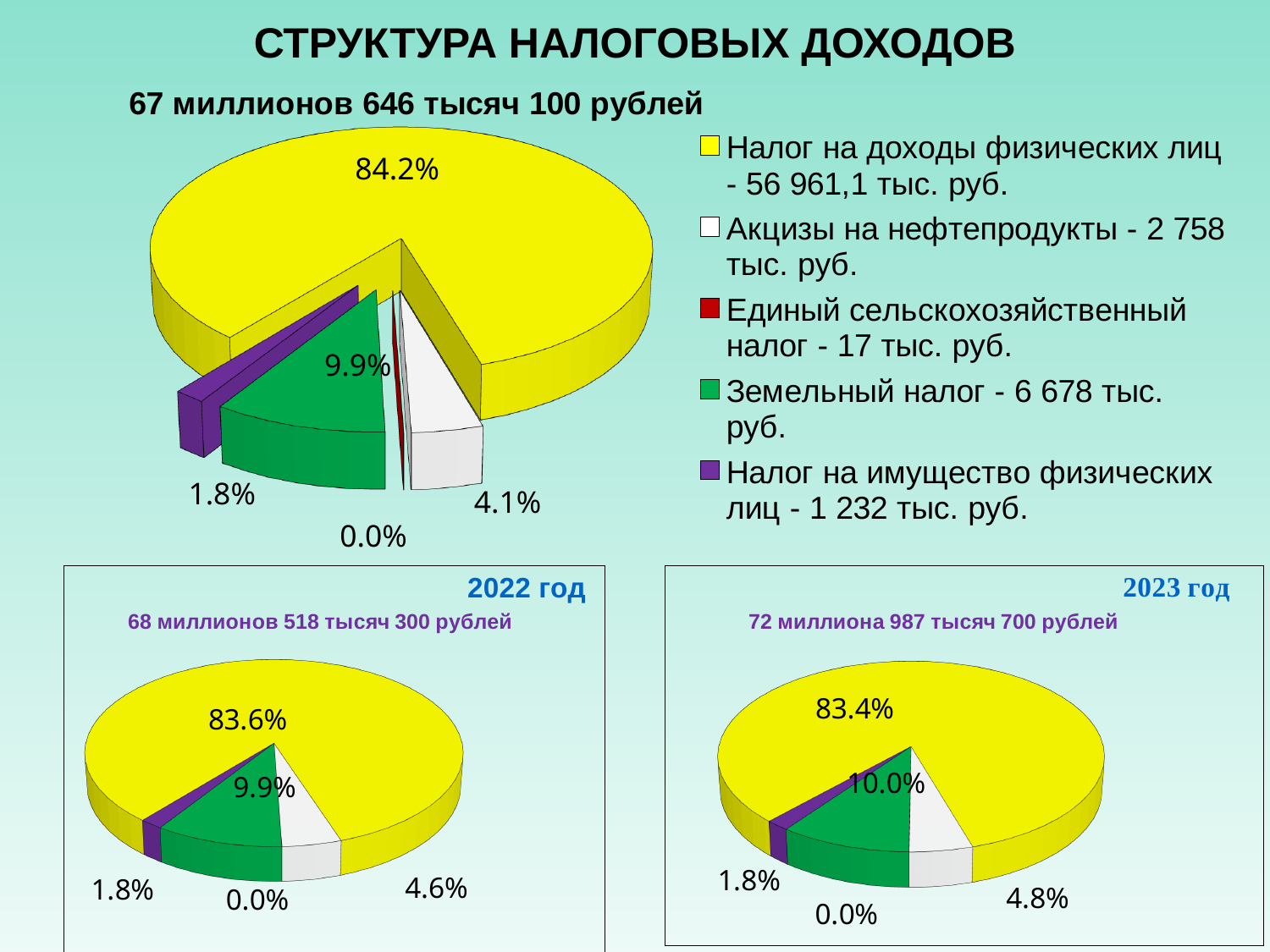
Which chart shows a larger share for the white slice: 2022 год (4.6%) or 2023 год (4.8%)? 2023 год What kind of chart is used on this slide? Pie chart How many categories does the legend of the top pie chart list? 5 On the 2023 год chart, what share is shown for the green slice? 10.0% On the top pie chart, what share is shown for Земельный налог (the green slice)? 9.9% What total amount is printed above the top pie chart? 67 миллионов 646 тысяч 100 рублей On the top pie chart, which category has the smallest slice? Единый сельскохозяйственный налог On the 2022 год chart, what share is shown for the largest (yellow) slice? 83.6% On the top pie chart, what is the difference in percentage points between the yellow slice (84.2%) and the green slice (9.9%)? 74.3 percentage points According to the legend of the top pie chart, what is the amount for Акцизы на нефтепродукты? 2 758 тыс. руб. On the top pie chart, which category has the largest slice? Налог на доходы физических лиц On the top pie chart, what share is shown for Налог на доходы физических лиц (the yellow slice)? 84.2%